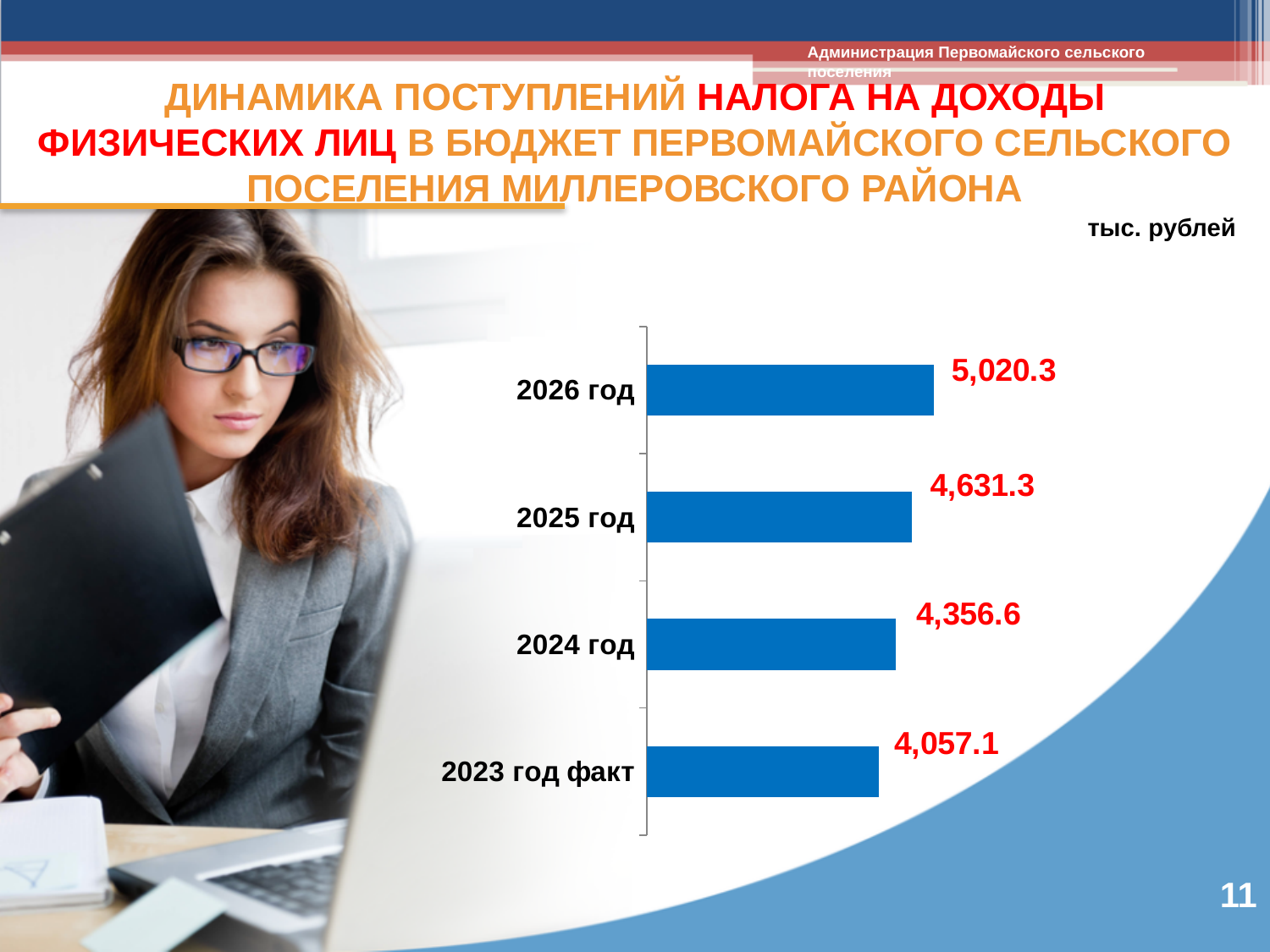
Which year has the highest value? 2026 год What kind of chart is shown on the slide? Bar chart Do the values rise or fall from 2023 год факт to 2026 год? Rise What is the value for 2026 год? 5,020.3 What is the value for 2023 год факт? 4,057.1 Which is larger, the value for 2024 год or the value for 2025 год? 2025 год How many years are shown in the chart? 4 What is the difference between the values for 2026 год and 2025 год? 389.0 Which year has the lowest value? 2023 год факт What is the value for 2025 год? 4,631.3 What is the value for 2024 год? 4,356.6 What is the difference between the values for 2026 год and 2023 год факт? 963.2